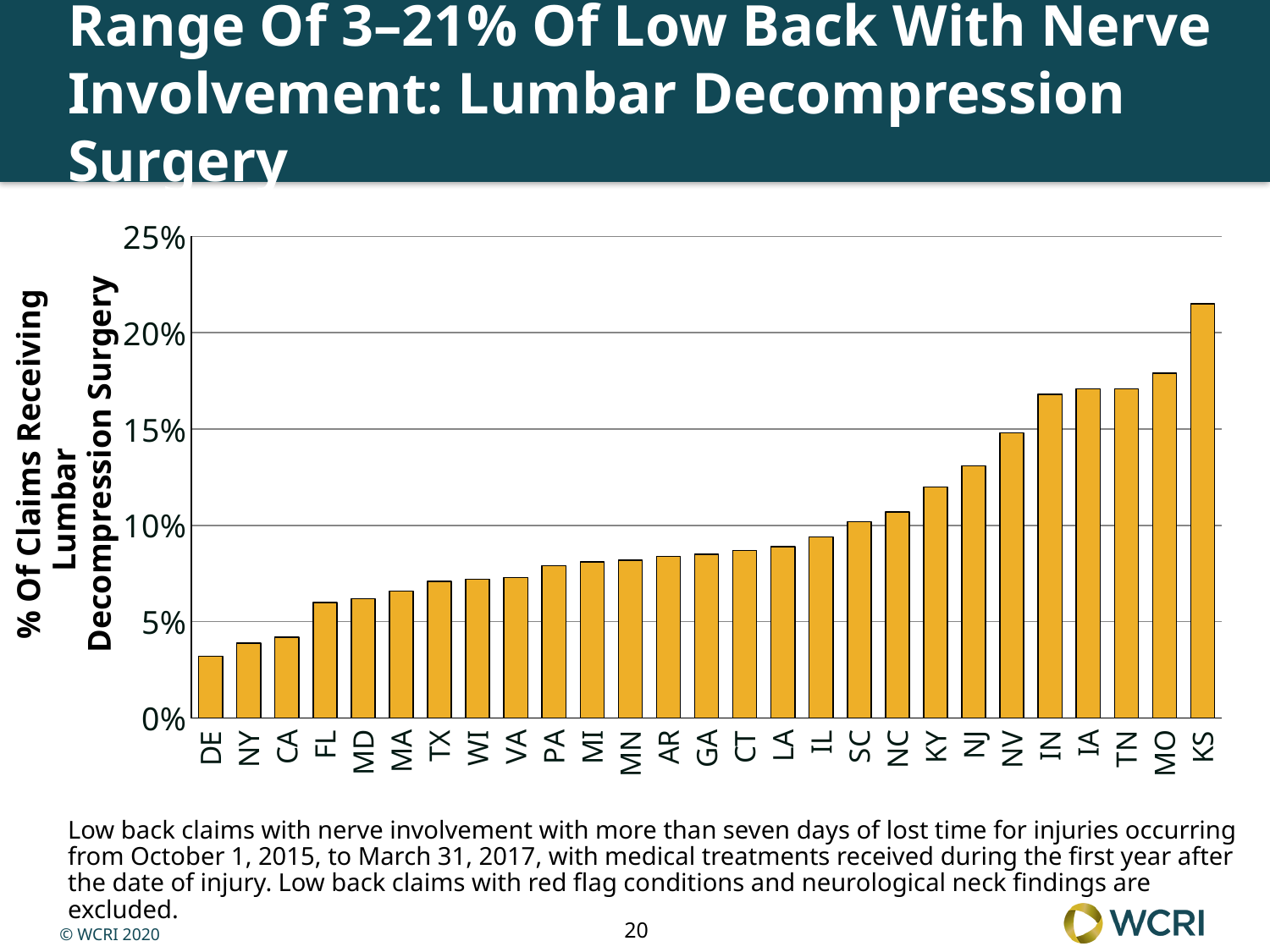
What kind of chart is shown on the slide? bar chart Which state has a higher value, MO or NV? MO How many states are shown on the x axis of the chart? 27 Do the bar values rise or fall moving from left to right along the x axis? rise Is the value for IL greater or less than 10%? less Which state has the highest percentage of claims receiving lumbar decompression surgery? KS Which state has the lowest percentage of claims receiving lumbar decompression surgery? DE What is the label of the y axis? % Of Claims Receiving Lumbar Decompression Surgery Is the value for DE greater or less than 5%? less Is the value for KS greater or less than 20%? greater